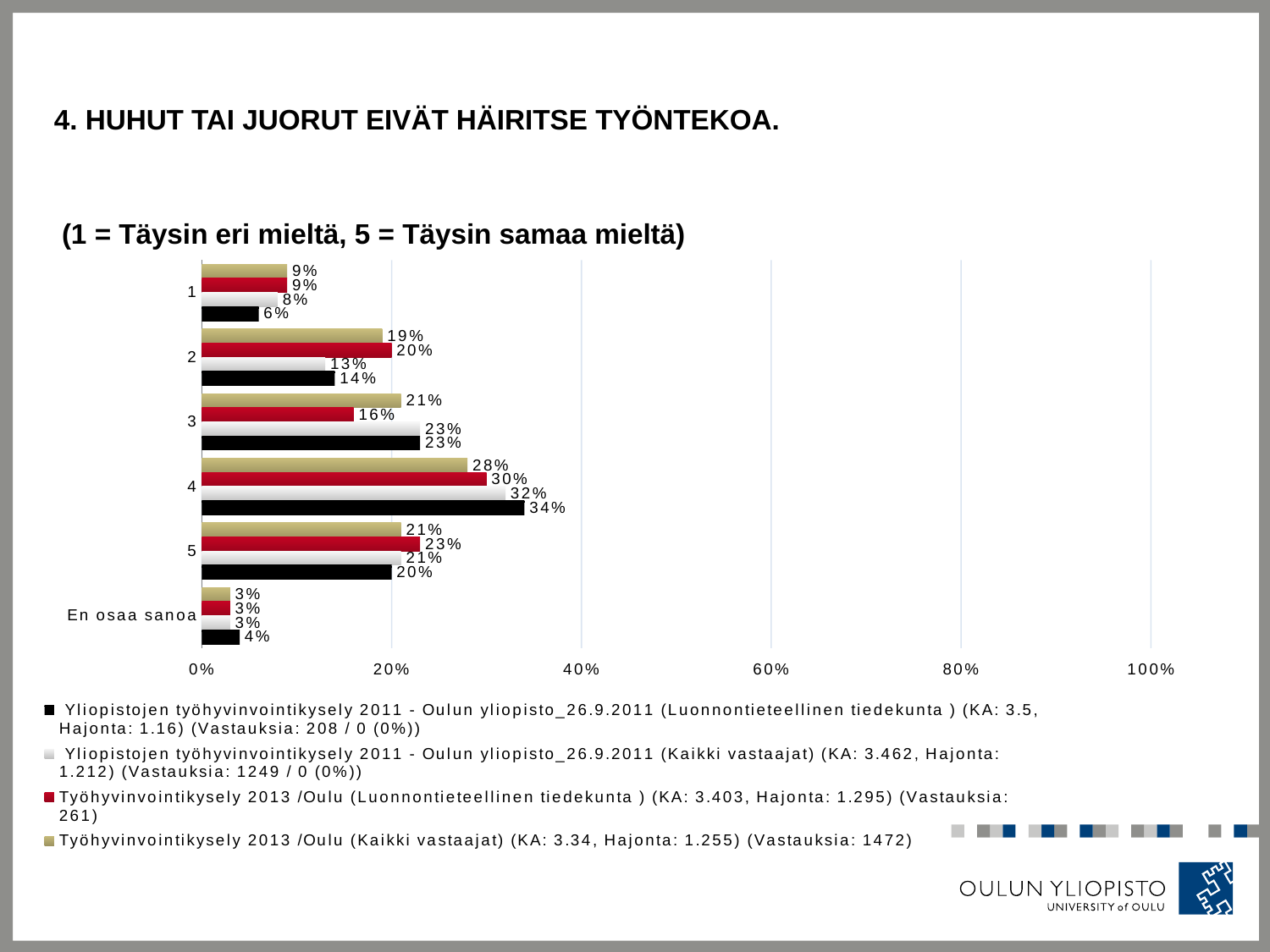
What is the value for 'En osaa sanoa' in the series 'Yliopistojen työhyvinvointikysely 2011 - Oulun yliopisto_26.9.2011 (Kaikki vastaajat)'? 3% What is the value for category 2 in the series 'Työhyvinvointikysely 2013 /Oulu (Kaikki vastaajat)'? 19% What type of chart is shown on the slide? bar chart What is the value for category 3 in the series 'Työhyvinvointikysely 2013 /Oulu (Luonnontieteellinen tiedekunta)'? 16% How many categories are shown on the vertical axis of the chart? 6 How many series does the legend list? 4 What is the difference between the 2011 Luonnontieteellinen tiedekunta value and the 2013 Kaikki vastaajat value for category 4? 6% What is the value for category 4 in the series 'Yliopistojen työhyvinvointikysely 2011 - Oulun yliopisto_26.9.2011 (Luonnontieteellinen tiedekunta)'? 34% Which category has the lowest value in the series 'Yliopistojen työhyvinvointikysely 2011 - Oulun yliopisto_26.9.2011 (Luonnontieteellinen tiedekunta)'? En osaa sanoa For category 2, which is larger: the 2013 Luonnontieteellinen tiedekunta value or the 2011 Kaikki vastaajat value? 2013 Luonnontieteellinen tiedekunta (20%) Is the value for category 4 in the series 'Yliopistojen työhyvinvointikysely 2011 - Oulun yliopisto_26.9.2011 (Kaikki vastaajat)' greater or less than 20%? greater Which category has the highest value in the series 'Työhyvinvointikysely 2013 /Oulu (Kaikki vastaajat)'? 4